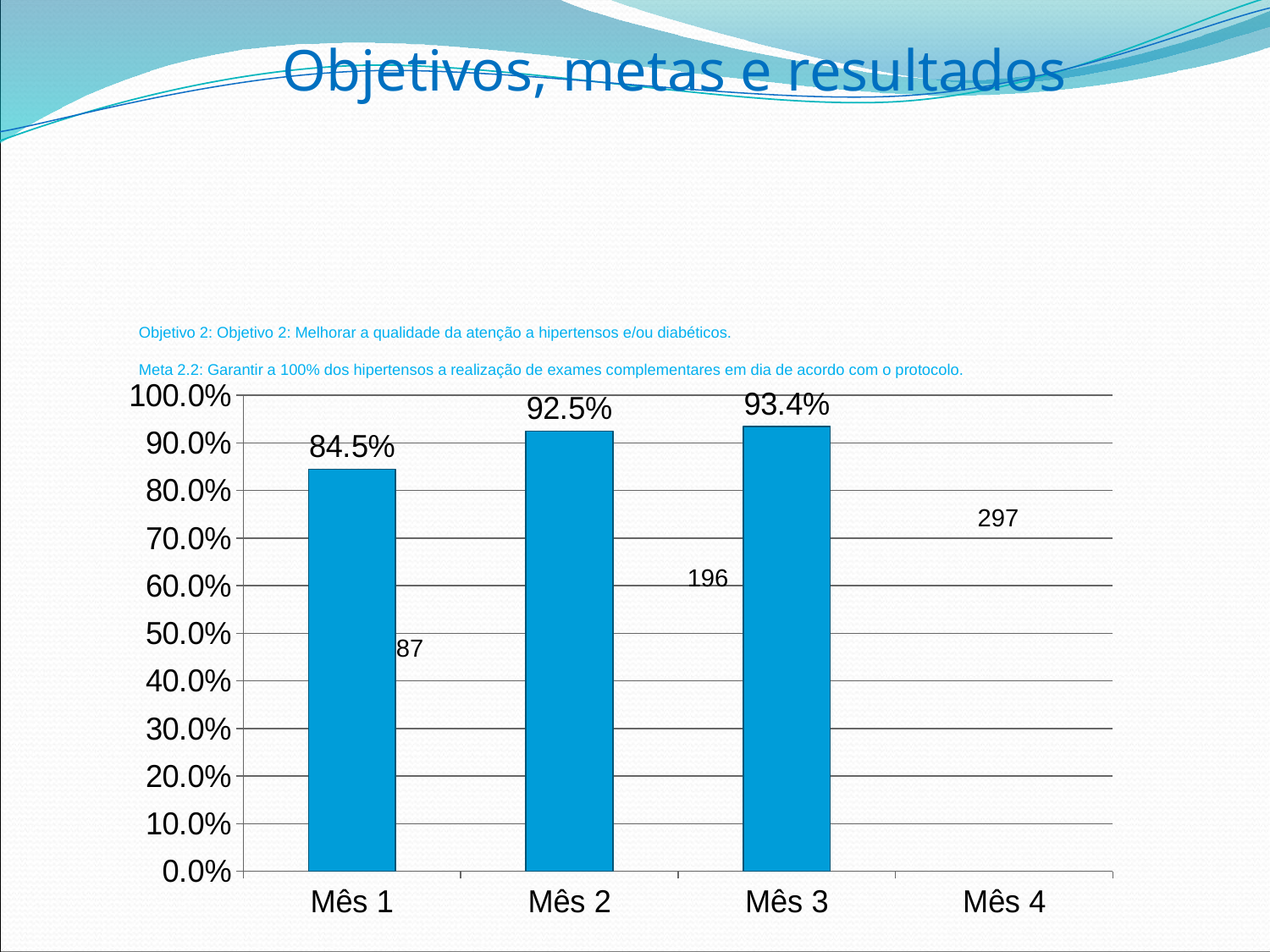
What is the value for Mês 1? 84.5% What is the value for Mês 2? 92.5% Which month has the highest percentage value? Mês 3 What is the value for Mês 3? 93.4% What is the difference between the values for Mês 2 and Mês 1? 8.0% Is the value for Mês 1 greater or less than 90.0%? less How many categories are shown on the x axis? 4 Do the percentage values rise or fall from Mês 1 to Mês 3? rise Which month with a plotted bar has the lowest percentage value? Mês 1 What is the maximum value shown on the y axis? 100.0% Which is larger, the value for Mês 1 or the value for Mês 2? Mês 2 What kind of chart is shown on the slide? bar chart